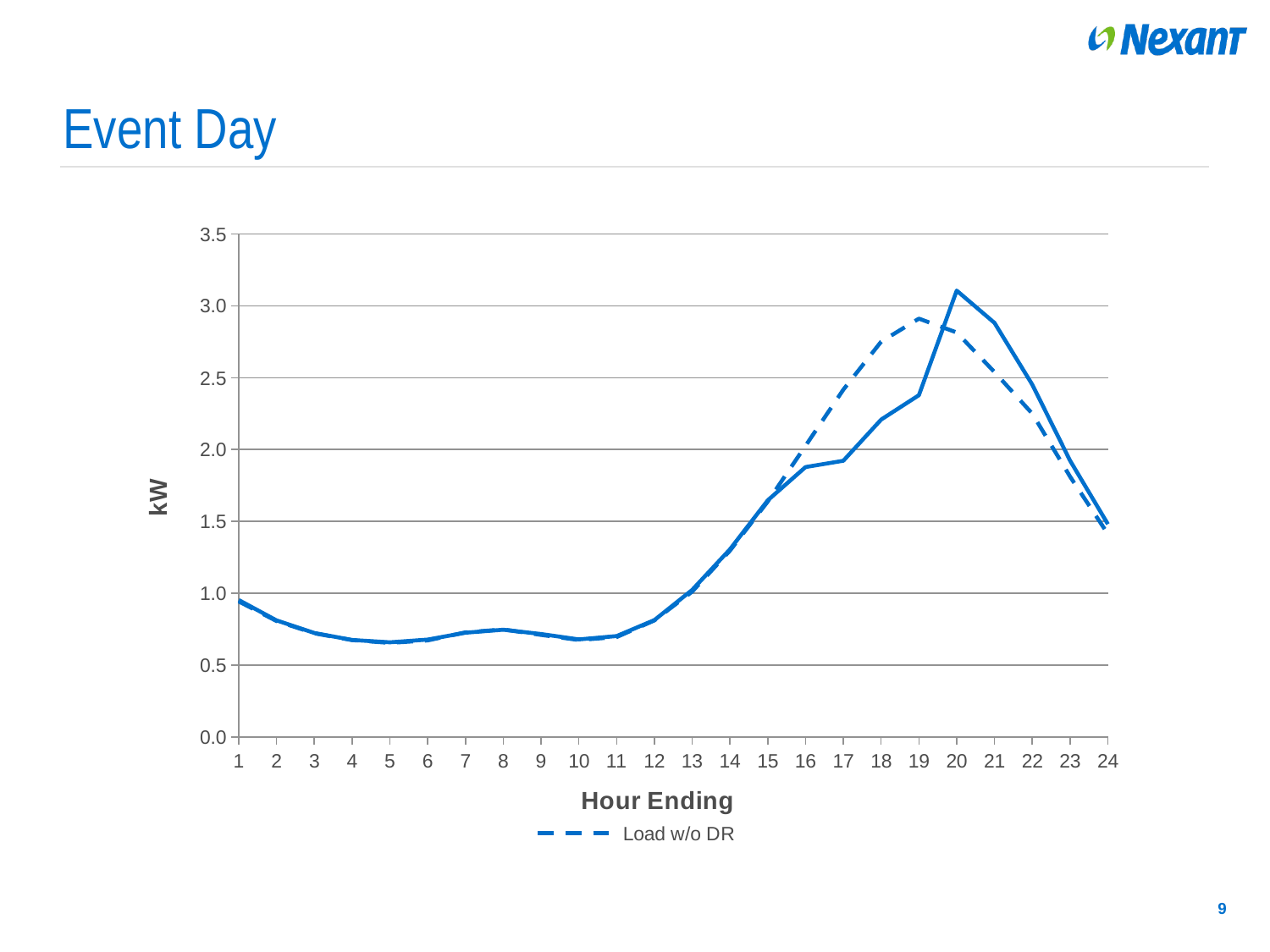
What is the label of the y axis? kW At which hour ending does the solid line reach its highest value? 20 How many hours are plotted along the x axis? 24 At hour ending 18, which line is higher, the dashed Load w/o DR line or the solid line? the dashed Load w/o DR line Do the values rise or fall from hour ending 1 to hour ending 5? fall How many series does the legend list? 1 Is the value of the solid line at hour ending 20 greater or less than 3.0? greater At which hour ending does the dashed Load w/o DR line reach its highest value? 19 Is the value of the dashed Load w/o DR line at hour ending 19 greater or less than 2.5? greater What kind of chart is shown on the slide? line chart What series name appears in the legend? Load w/o DR Is the value at hour ending 5 greater or less than 1.0? less